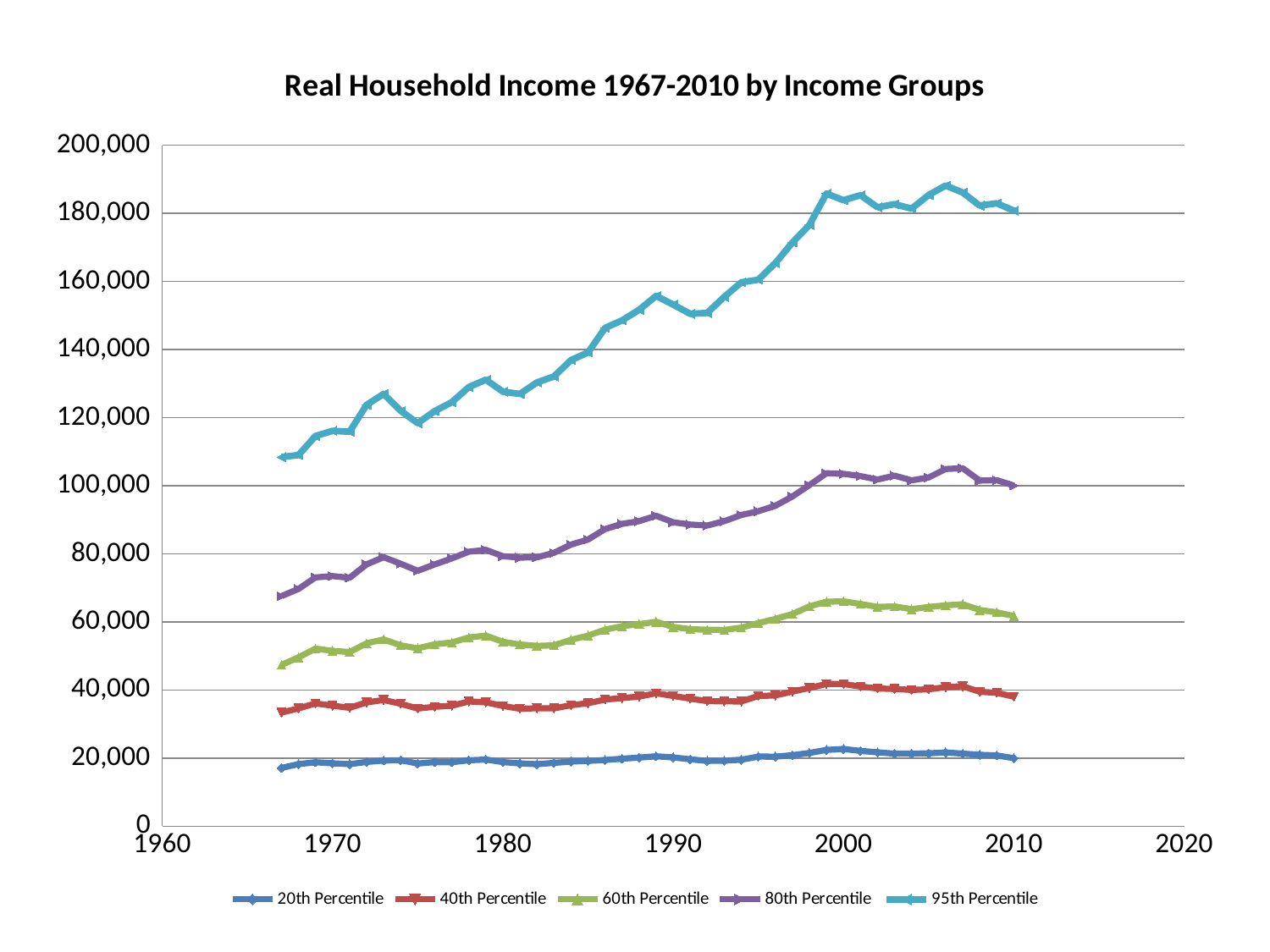
Is the value for the 80th Percentile in 1967 greater or less than 60,000? greater How many series does the legend list? 5 Does the 95th Percentile series generally rise or fall from 1967 to 2010? rise What kind of chart is shown on the slide? line chart Which series has the highest values throughout the chart? 95th Percentile Is the value for the 95th Percentile in 2000 greater or less than 180,000? greater Is the value for the 95th Percentile in 1967 greater or less than 100,000? greater Which series has the lowest values throughout the chart? 20th Percentile What is the title of the chart? Real Household Income 1967-2010 by Income Groups In 2000, which is larger: the 95th Percentile value or the 80th Percentile value? 95th Percentile